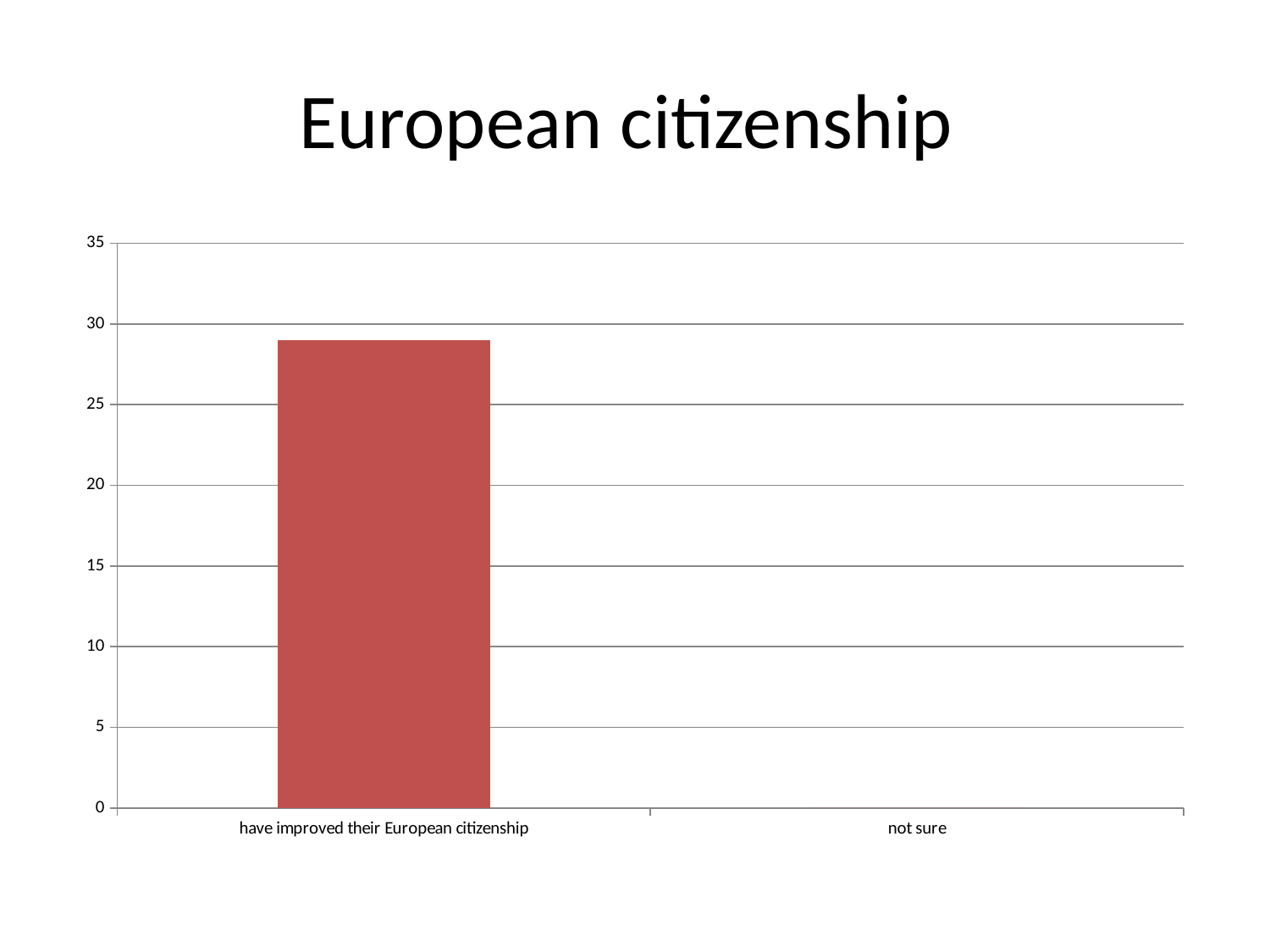
What is the title of the chart? European citizenship Is the value for "have improved their European citizenship" greater or less than 25? greater What is the highest value shown on the y axis of the chart? 35 Which category has the lowest value in the chart? not sure Which is larger, the value for "have improved their European citizenship" or the value for "not sure"? have improved their European citizenship Which category has the highest value in the chart? have improved their European citizenship Is the value for "have improved their European citizenship" greater or less than 30? less How many categories are shown on the x axis of the chart? 2 What kind of chart is shown on the slide? bar chart